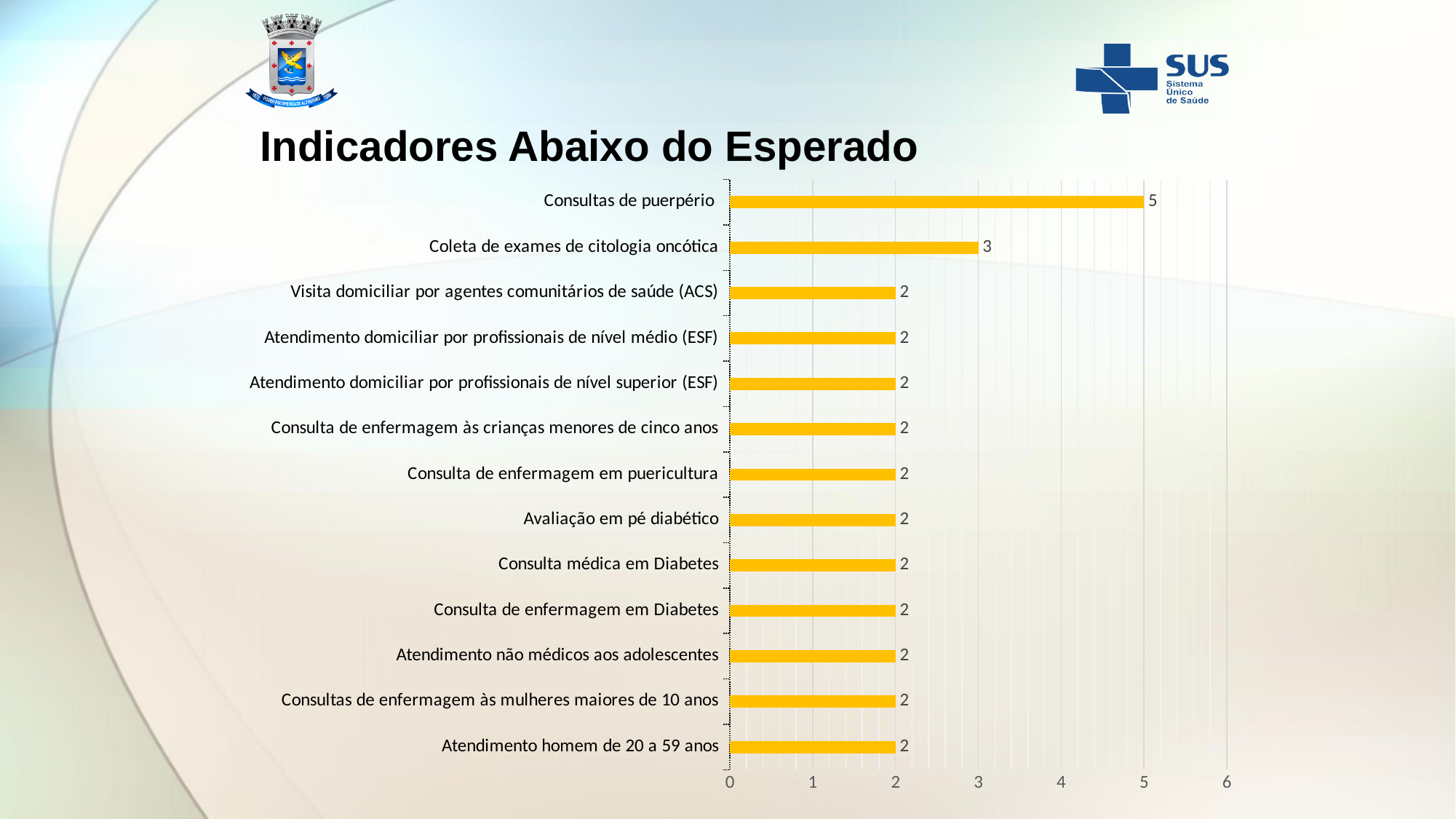
What is the value for Atendimento homem de 20 a 59 anos? 2 What is the title of the slide? Indicadores Abaixo do Esperado What is the difference between the values for Consultas de puerpério and Coleta de exames de citologia oncótica? 2 Which is larger, the value for Consultas de puerpério or the value for Visita domiciliar por agentes comunitários de saúde (ACS)? Consultas de puerpério What is the value for Coleta de exames de citologia oncótica? 3 What is the value for Avaliação em pé diabético? 2 What type of chart is shown on the slide? bar chart Which category has the highest value? Consultas de puerpério What is the value for Consultas de puerpério? 5 How many categories are shown in the chart? 13 Is the value for Consultas de puerpério greater or less than 4? greater What is the difference between the values for Coleta de exames de citologia oncótica and Consulta médica em Diabetes? 1